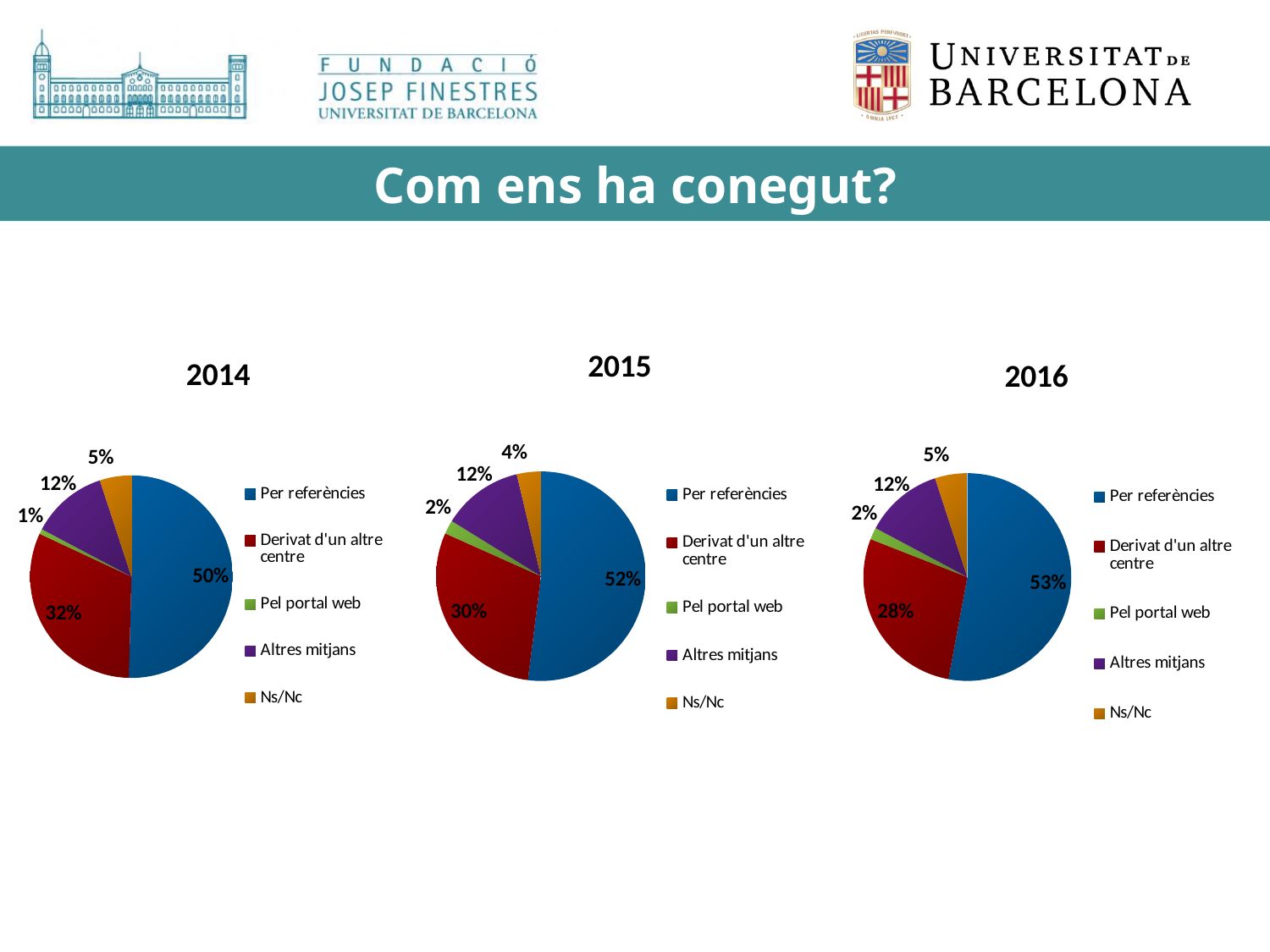
In the 2016 chart, which is larger: Altres mitjans or Ns/Nc? Altres mitjans In the 2016 chart, what share is labelled for Derivat d'un altre centre? 28% In the 2014 chart, what share is labelled for Derivat d'un altre centre? 32% In the 2014 chart, which category has the smallest slice? Pel portal web How many entries does the legend of the 2016 chart list? 5 In the 2015 chart, what share is labelled for Ns/Nc? 4% In the 2016 chart, which category has the largest slice? Per referències In the 2014 chart, what share is labelled for Per referències? 50% In the 2015 chart, what is the difference between the Per referències share and the Derivat d'un altre centre share? 22% What kind of chart is the 2014 chart? Pie chart What is the title of the 2015 chart? 2015 How many slices does the 2015 chart have? 5